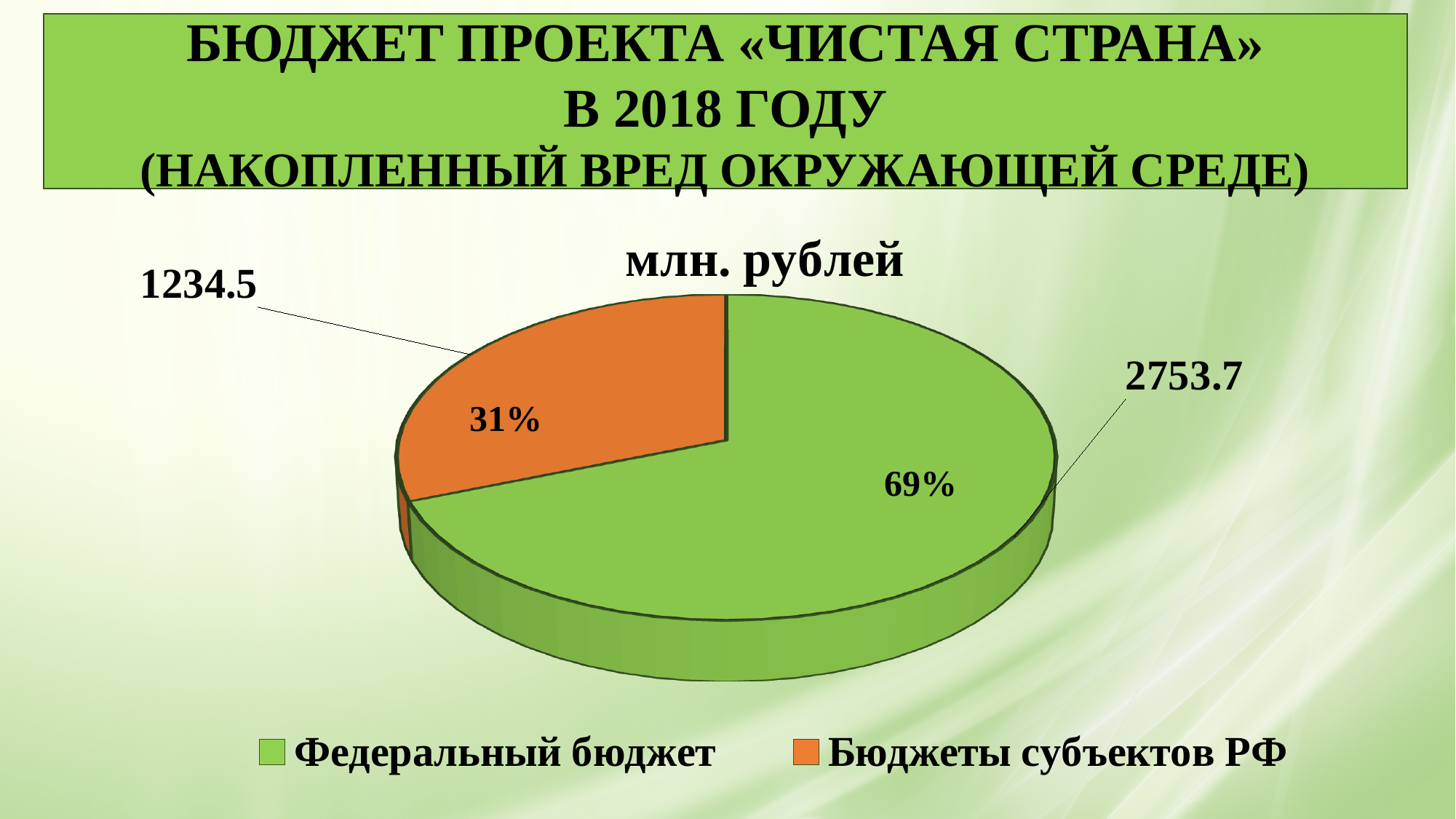
How many slices does the pie chart have? 2 What share of the pie does Федеральный бюджет take? 69% What is the title of the chart? млн. рублей What kind of chart is shown on the slide? Pie chart What is the value for Федеральный бюджет? 2753.7 What share of the pie does Бюджеты субъектов РФ take? 31% Which category has the smallest slice? Бюджеты субъектов РФ Which category has the largest slice? Федеральный бюджет What is the difference between the values for Федеральный бюджет and Бюджеты субъектов РФ? 1519.2 What is the value for Бюджеты субъектов РФ? 1234.5 Which is larger, Федеральный бюджет or Бюджеты субъектов РФ? Федеральный бюджет What colour is the slice for Бюджеты субъектов РФ? Orange